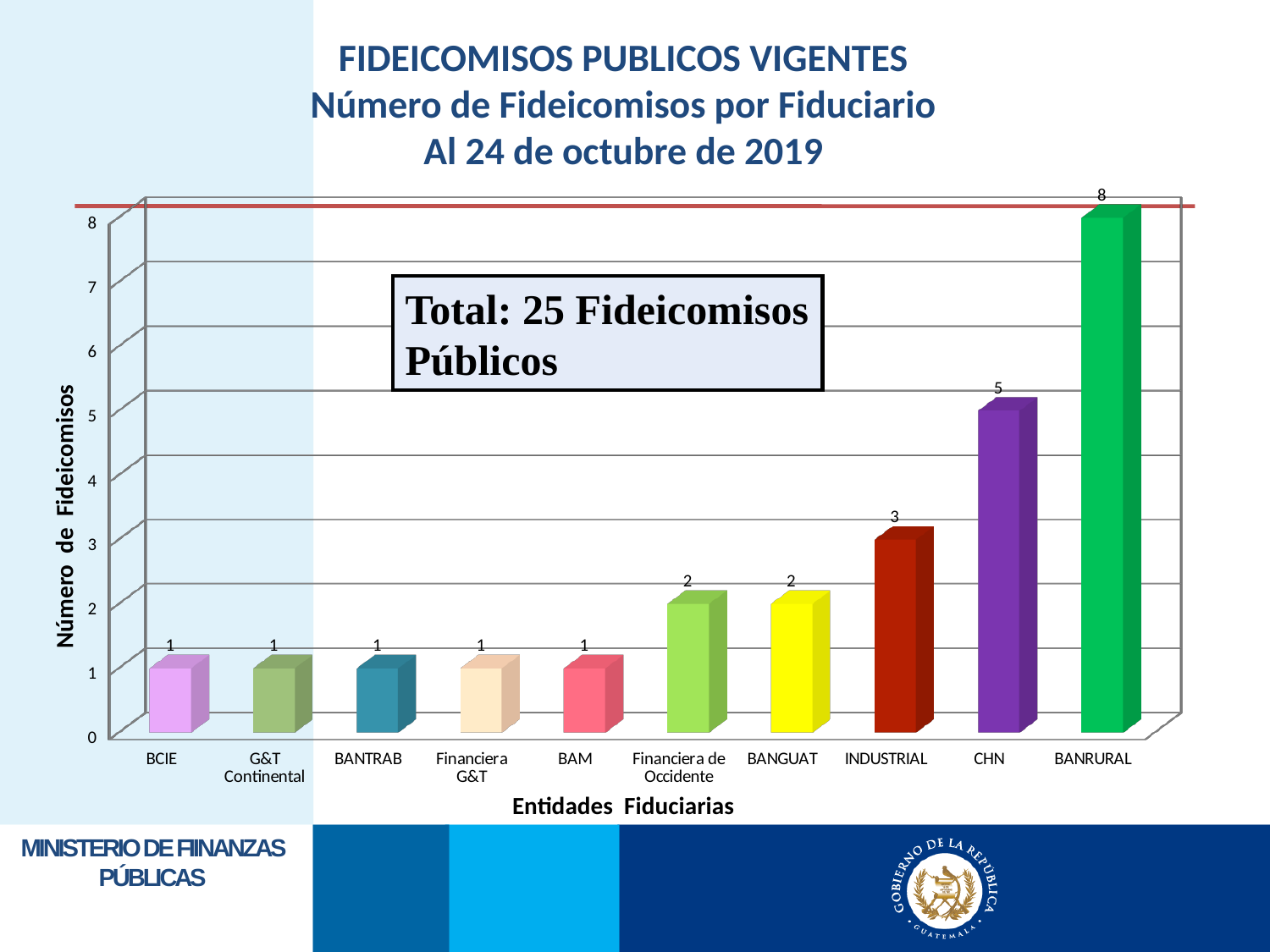
What is the value for BANGUAT? 2 What is the value for CHN? 5 What is the difference between the values for BANRURAL and CHN? 3 What kind of chart is shown on the slide? bar chart What is the value for BANRURAL? 8 Which entity has the highest number of fideicomisos? BANRURAL Do the values generally rise or fall from left to right along the x axis? rise How many entities have a value of 1? 5 Which is larger, the value for INDUSTRIAL or the value for Financiera de Occidente? INDUSTRIAL What is the x-axis title of the chart? Entidades Fiduciarias What is the value for INDUSTRIAL? 3 How many entities are shown on the x axis? 10